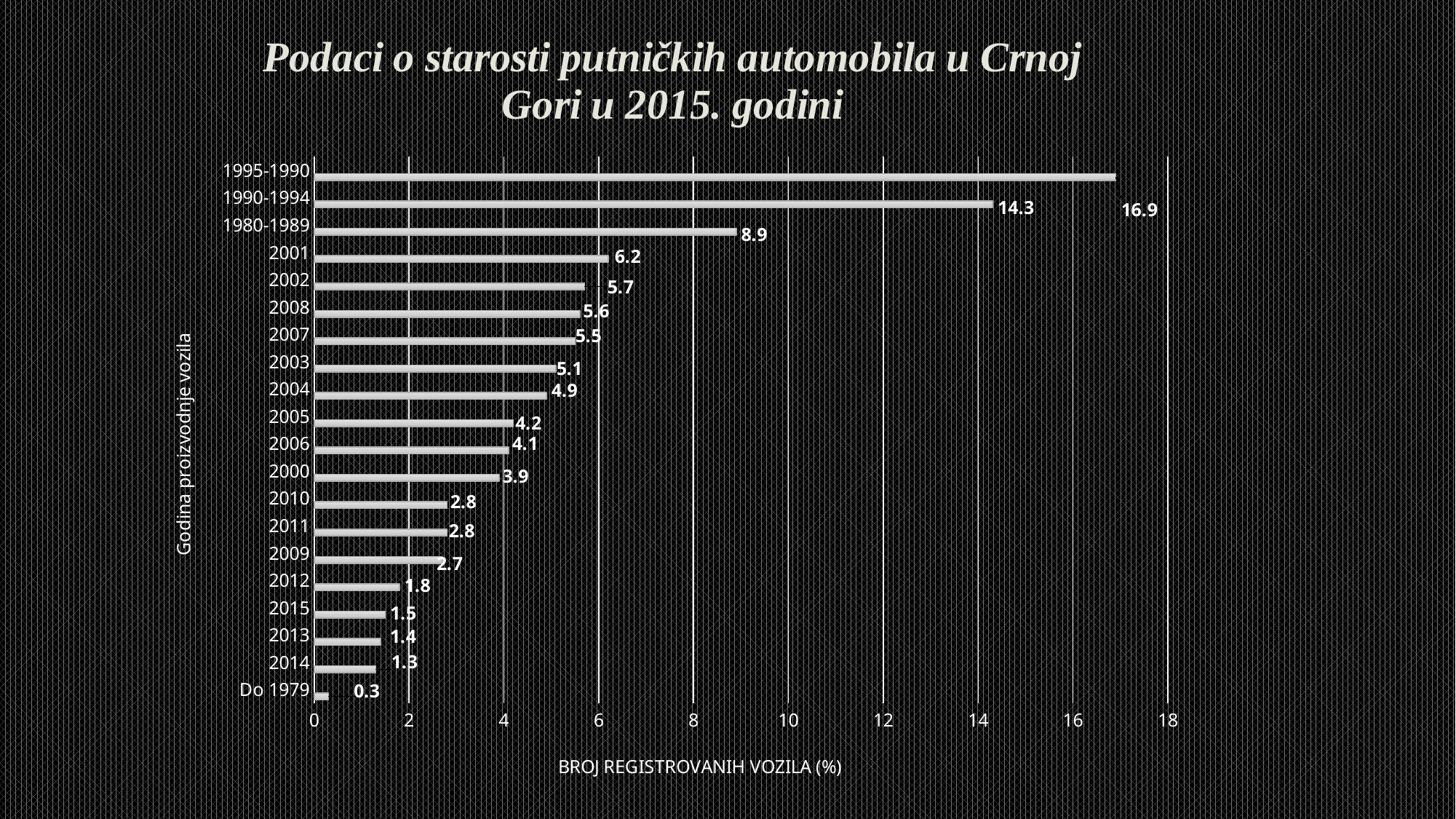
What is the difference between the values for 2001 and 2000? 2.3 What is the value for 2004? 4.9 What kind of chart is shown on the slide? bar chart What is the value for 1980-1989? 8.9 What is the value for Do 1979? 0.3 What is the label of the horizontal axis? BROJ REGISTROVANIH VOZILA (%) How many categories are shown on the chart? 20 Which category has the lowest value? Do 1979 Which is larger, the value for 2005 or the value for 2012? 2005 Is the value for 1980-1989 greater or less than 8? greater What is the difference between the values for 1995-1990 and 1990-1994? 2.6 Which category has the highest value? 1995-1990